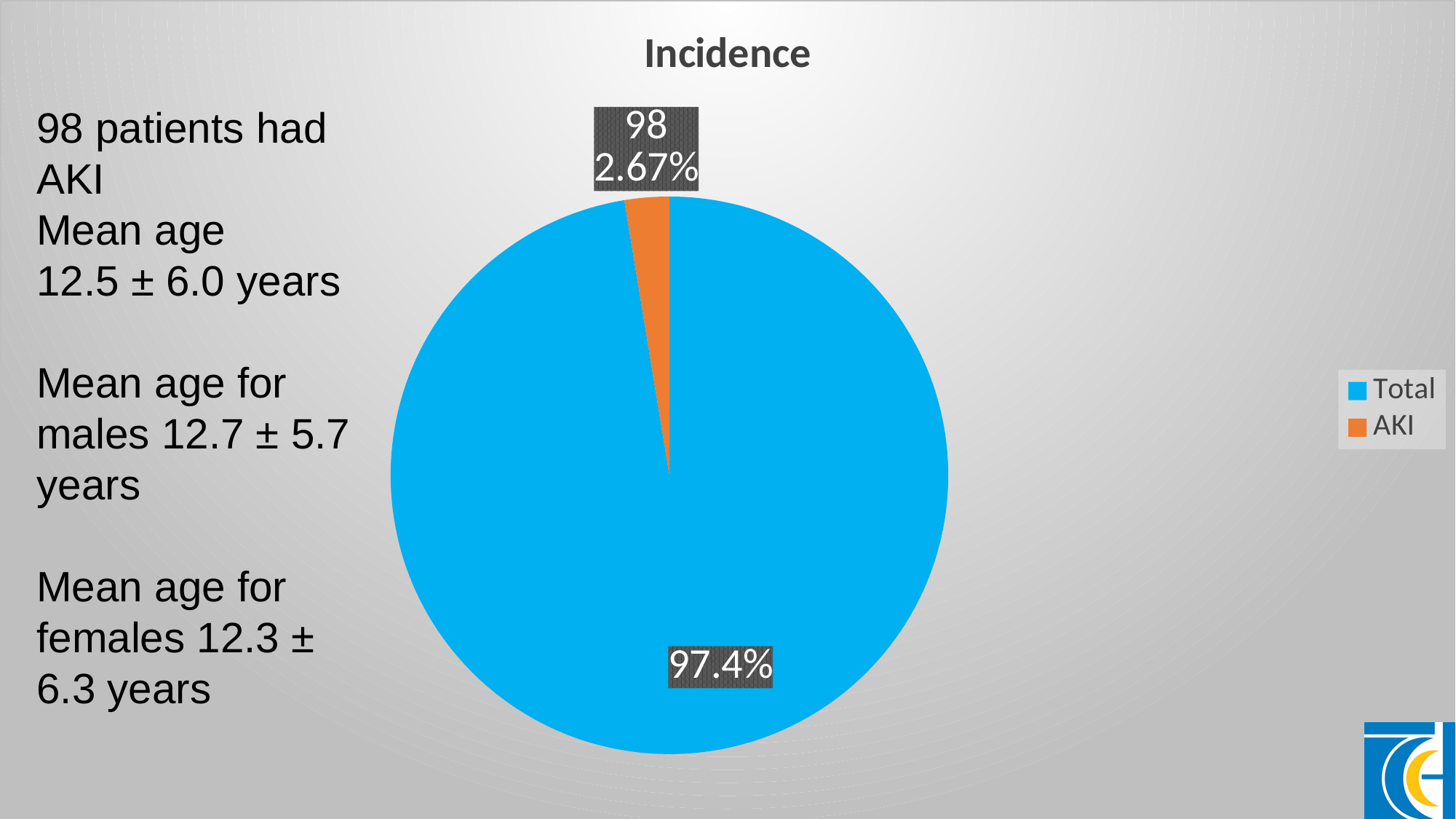
What percentage share does the Total slice have? 97.4% How many entries does the legend list? 2 Which slice is larger, Total or AKI? Total What is the title of the chart? Incidence What percentage share does the AKI slice have? 2.67% How many slices does the pie chart have? 2 What value is printed on the AKI slice? 98 Which slice is the largest? Total What kind of chart is shown on the slide? pie chart Which slice is the smallest? AKI What colour is the AKI slice? orange